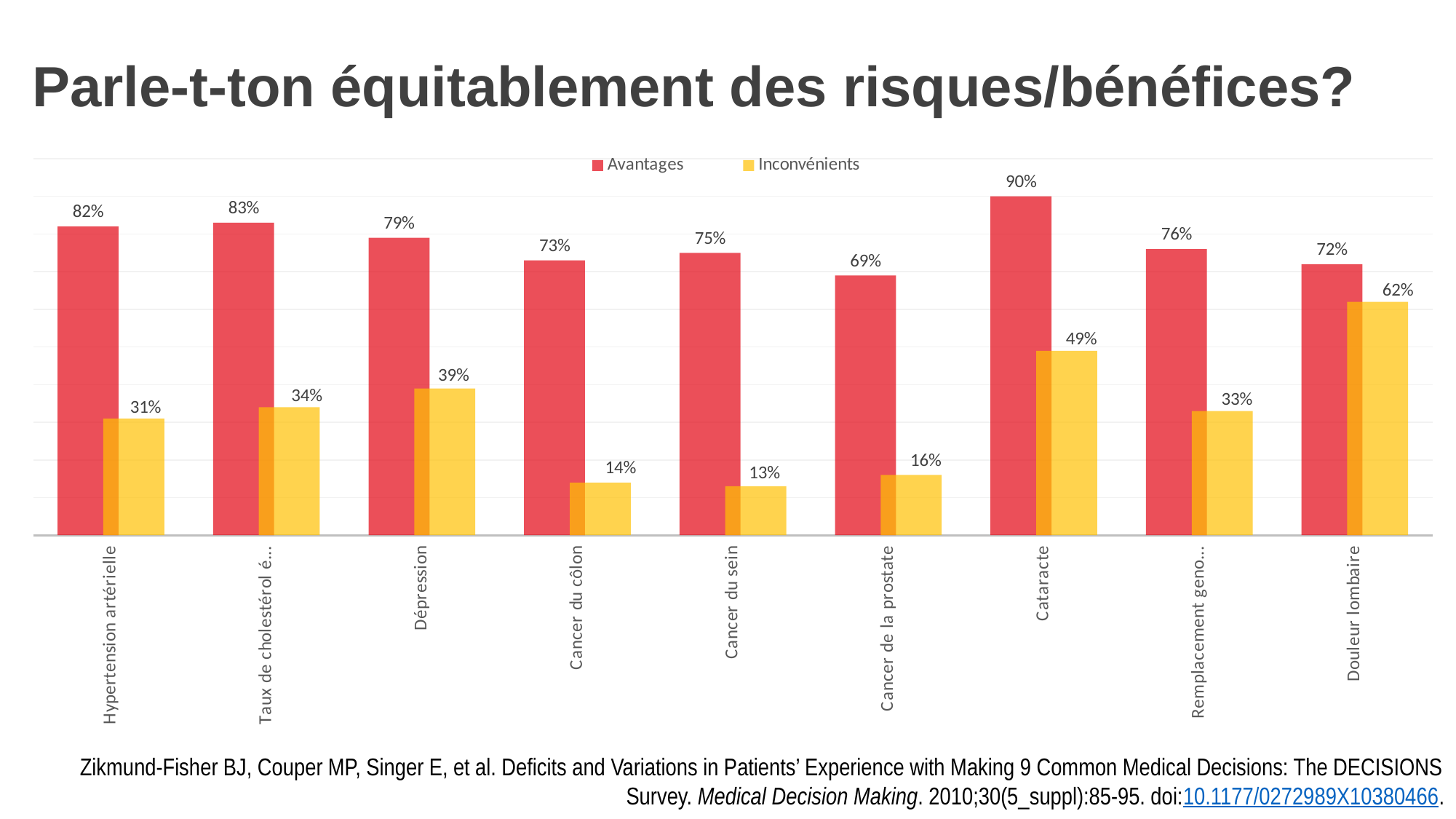
Which category has the lowest Inconvénients value? Cancer du sein What is the difference between the Avantages and Inconvénients values for Hypertension artérielle? 51% How many series does the legend list? 2 What is the difference between the Avantages values for Cataracte and Douleur lombaire? 18% How many categories are shown on the x axis? 9 What is the Avantages value for Cataracte? 90% What is the Inconvénients value for Douleur lombaire? 62% What is the Avantages value for Cancer de la prostate? 69% Which series is shown in yellow? Inconvénients Which is larger, the Inconvénients value for Dépression or for Cancer du côlon? Dépression What type of chart is shown on the slide? bar chart Which category has the highest Avantages value? Cataracte